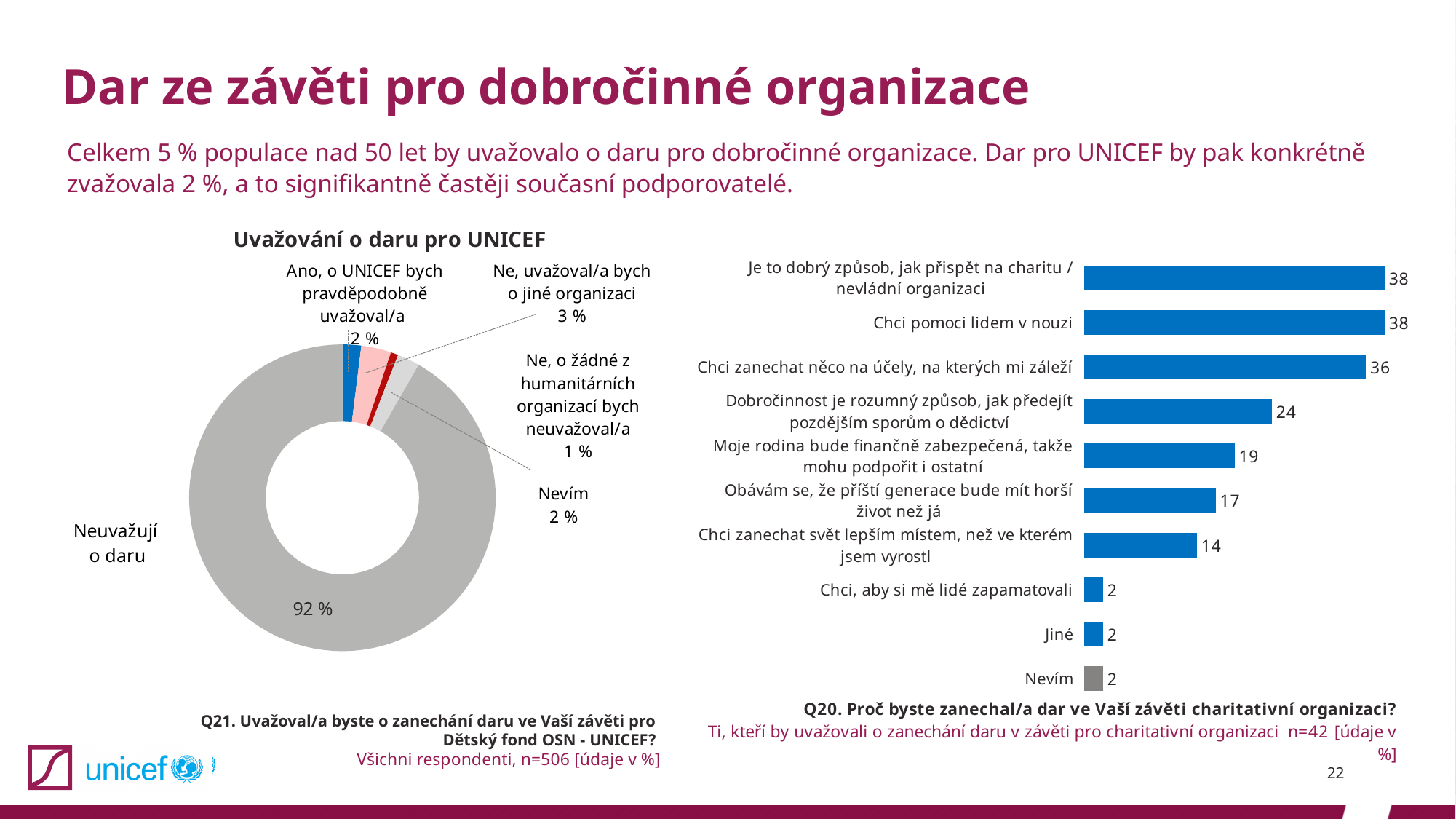
In the donut chart 'Uvažování o daru pro UNICEF', which category has the largest share? Neuvažují o daru How many categories are shown in the bar chart on the right (Q20)? 10 In the donut chart 'Uvažování o daru pro UNICEF', what share is shown for 'Ne, uvažoval/a bych o jiné organizaci'? 3 % What kind of chart is the chart on the left titled 'Uvažování o daru pro UNICEF'? Donut (pie) chart In the bar chart on the right (Q20), what is the value for 'Chci pomoci lidem v nouzi'? 38 In the donut chart 'Uvažování o daru pro UNICEF', how much larger is the share for 'Ne, uvažoval/a bych o jiné organizaci' than for 'Ne, o žádné z humanitárních organizací bych neuvažoval/a'? 2 percentage points In the bar chart on the right (Q20), what is the value for 'Nevím'? 2 In the donut chart 'Uvažování o daru pro UNICEF', what share is shown for 'Neuvažují o daru'? 92 % In the bar chart on the right (Q20), what is the value for 'Dobročinnost je rozumný způsob, jak předejít pozdějším sporům o dědictví'? 24 In the bar chart on the right (Q20), which is larger: 'Moje rodina bude finančně zabezpečená, takže mohu podpořit i ostatní' or 'Obávám se, že příští generace bude mít horší život než já'? Moje rodina bude finančně zabezpečená, takže mohu podpořit i ostatní In the bar chart on the right (Q20), what is the difference between 'Chci zanechat něco na účely, na kterých mi záleží' and 'Chci zanechat svět lepším místem, než ve kterém jsem vyrostl'? 22 In the bar chart on the right (Q20), what colour is the bar for 'Nevím'? Grey